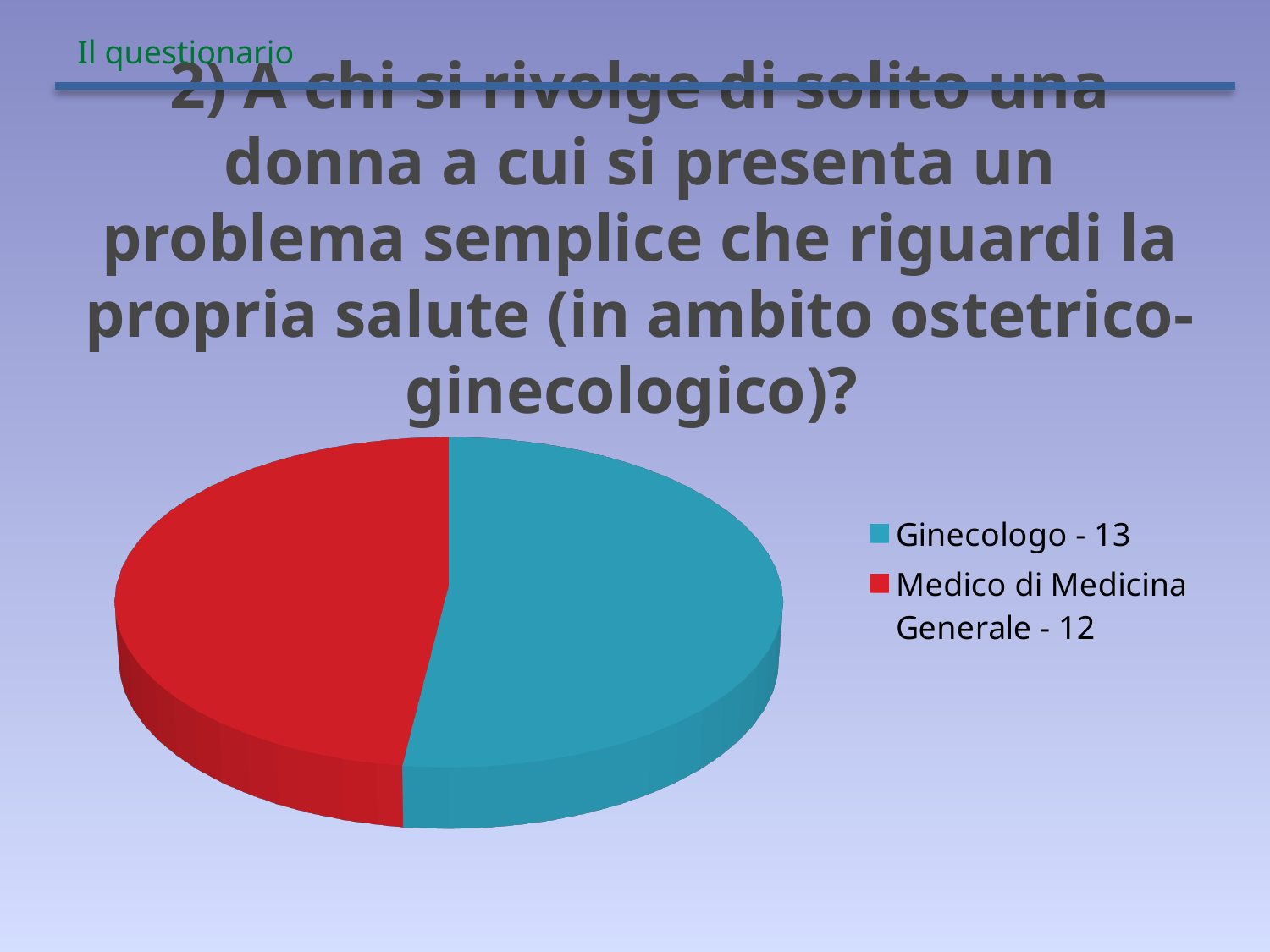
What share of the pie does Ginecologo represent? 52% How many entries does the legend list? 2 What is the difference between the values for Ginecologo and Medico di Medicina Generale? 1 What kind of chart is shown on the slide? pie chart What colour is the Ginecologo slice in the pie chart? blue How many categories does the pie chart show? 2 Which category has the smallest slice of the pie chart? Medico di Medicina Generale What is the total of the two values shown in the pie chart? 25 Which is larger, the value for Ginecologo or the value for Medico di Medicina Generale? Ginecologo What value is shown for Ginecologo in the pie chart? 13 What value is shown for Medico di Medicina Generale in the pie chart? 12 Which category has the largest slice of the pie chart? Ginecologo